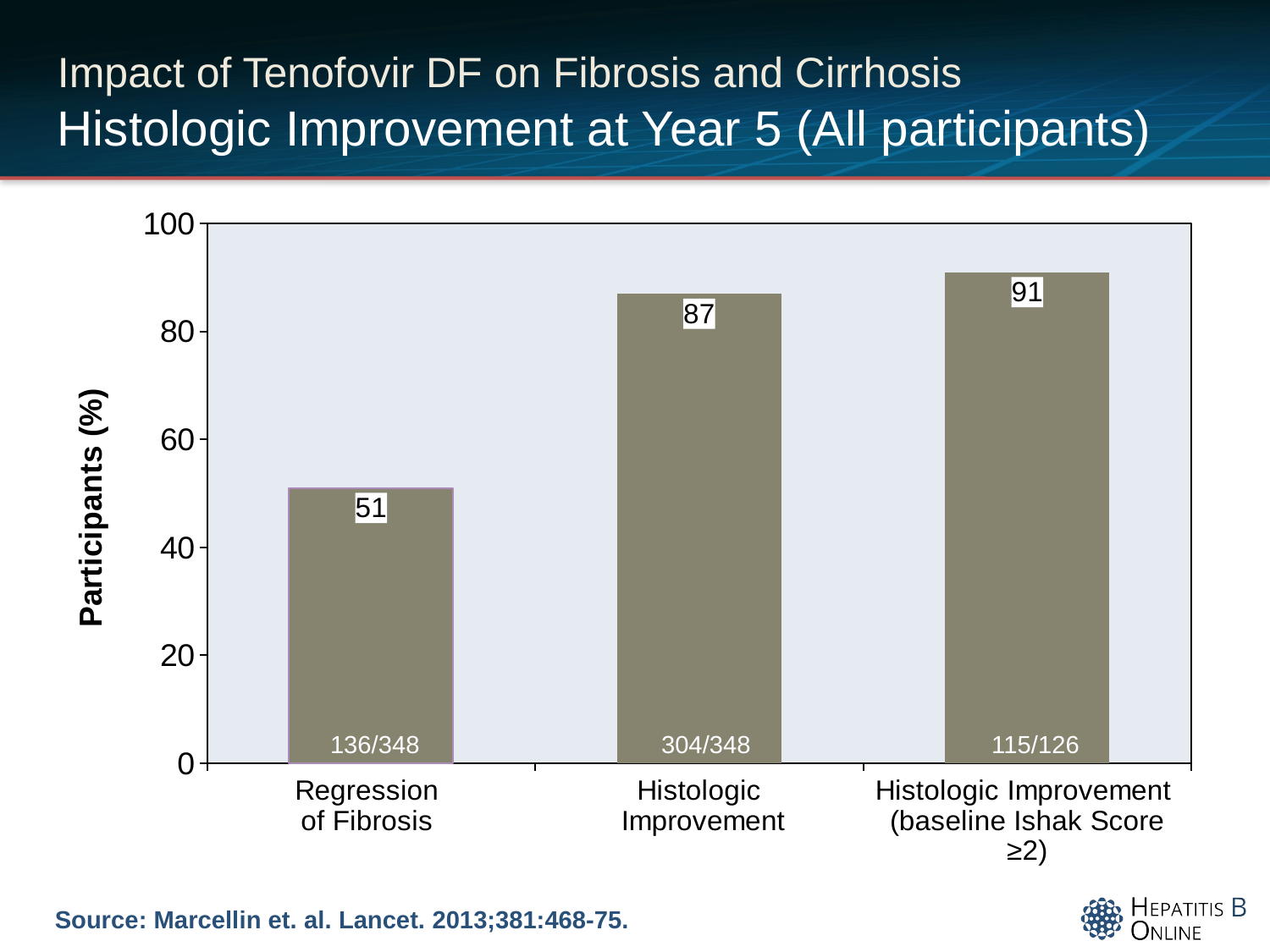
What percentage of participants showed Histologic Improvement? 87 What is the difference in percentage points between Histologic Improvement and Regression of Fibrosis? 36 What kind of chart is shown on the slide? Bar chart What percentage of participants with baseline Ishak Score ≥2 showed Histologic Improvement? 91 How many categories are shown on the chart? 3 What fraction of participants is printed on the Histologic Improvement bar? 304/348 Which category has the lowest percentage of participants? Regression of Fibrosis What percentage of participants showed Regression of Fibrosis? 51 Which category has the highest percentage of participants? Histologic Improvement (baseline Ishak Score ≥2) Which is larger, the value for Regression of Fibrosis or the value for Histologic Improvement? Histologic Improvement Is the value for Regression of Fibrosis greater or less than 60? less What is the difference in percentage points between Histologic Improvement (baseline Ishak Score ≥2) and Histologic Improvement? 4